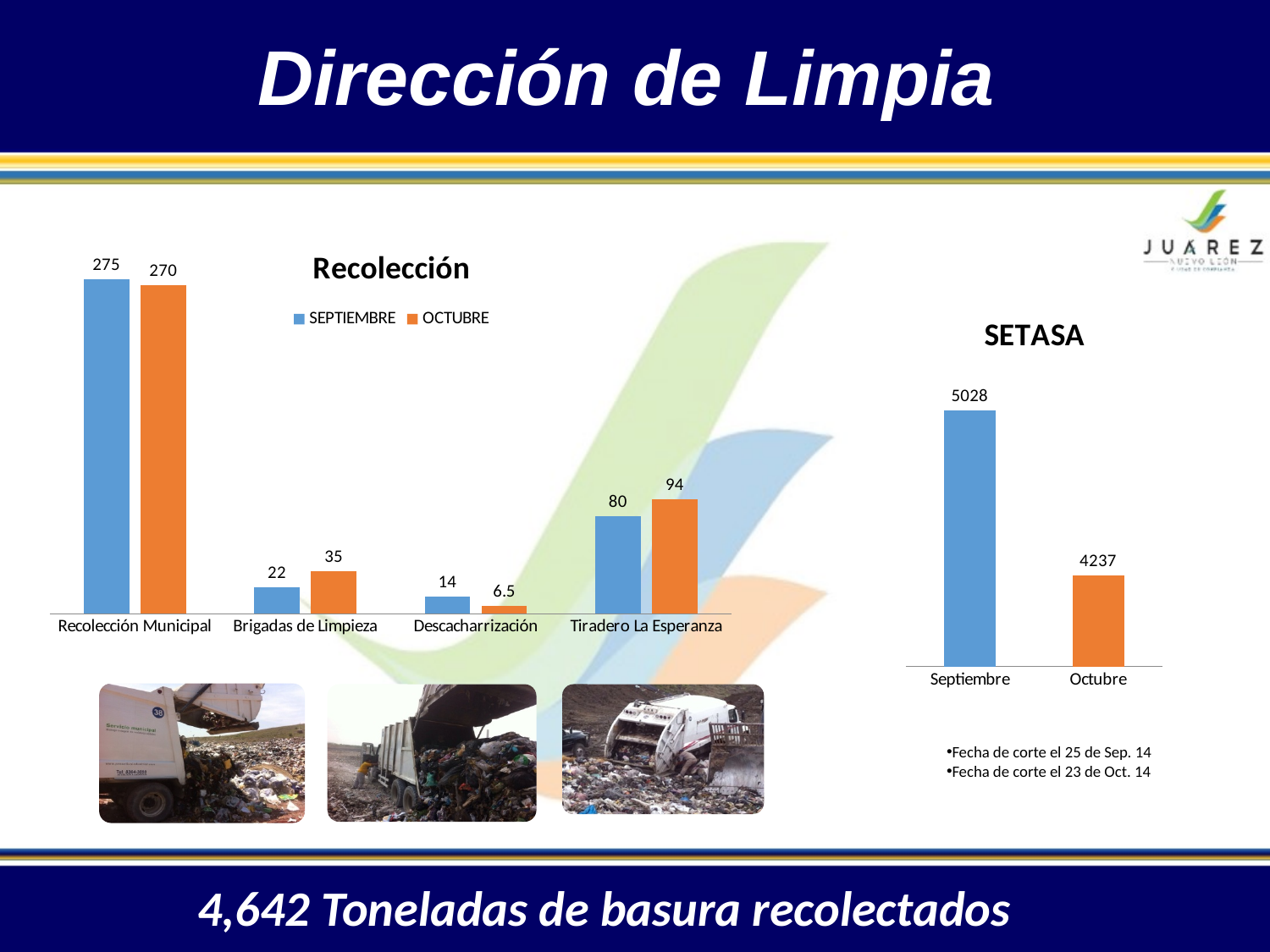
In the Recolección chart, is the SEPTIEMBRE or OCTUBRE value larger for Brigadas de Limpieza? OCTUBRE In the SETASA chart, what is the value for Octubre? 4237 How many series does the legend of the Recolección chart list? 2 What kind of chart is the SETASA chart? Bar chart In the Recolección chart, which category has the lowest OCTUBRE value? Descacharrización In the Recolección chart, what is the SEPTIEMBRE value for Recolección Municipal? 275 How many categories are shown on the x axis of the Recolección chart? 4 In the Recolección chart, what is the difference between the OCTUBRE and SEPTIEMBRE values for Tiradero La Esperanza? 14 In the Recolección chart, what is the OCTUBRE value for Brigadas de Limpieza? 35 In the SETASA chart, what is the difference between the Septiembre and Octubre values? 791 In the Recolección chart, what is the OCTUBRE value for Descacharrización? 6.5 In the Recolección chart, which category has the highest SEPTIEMBRE value? Recolección Municipal